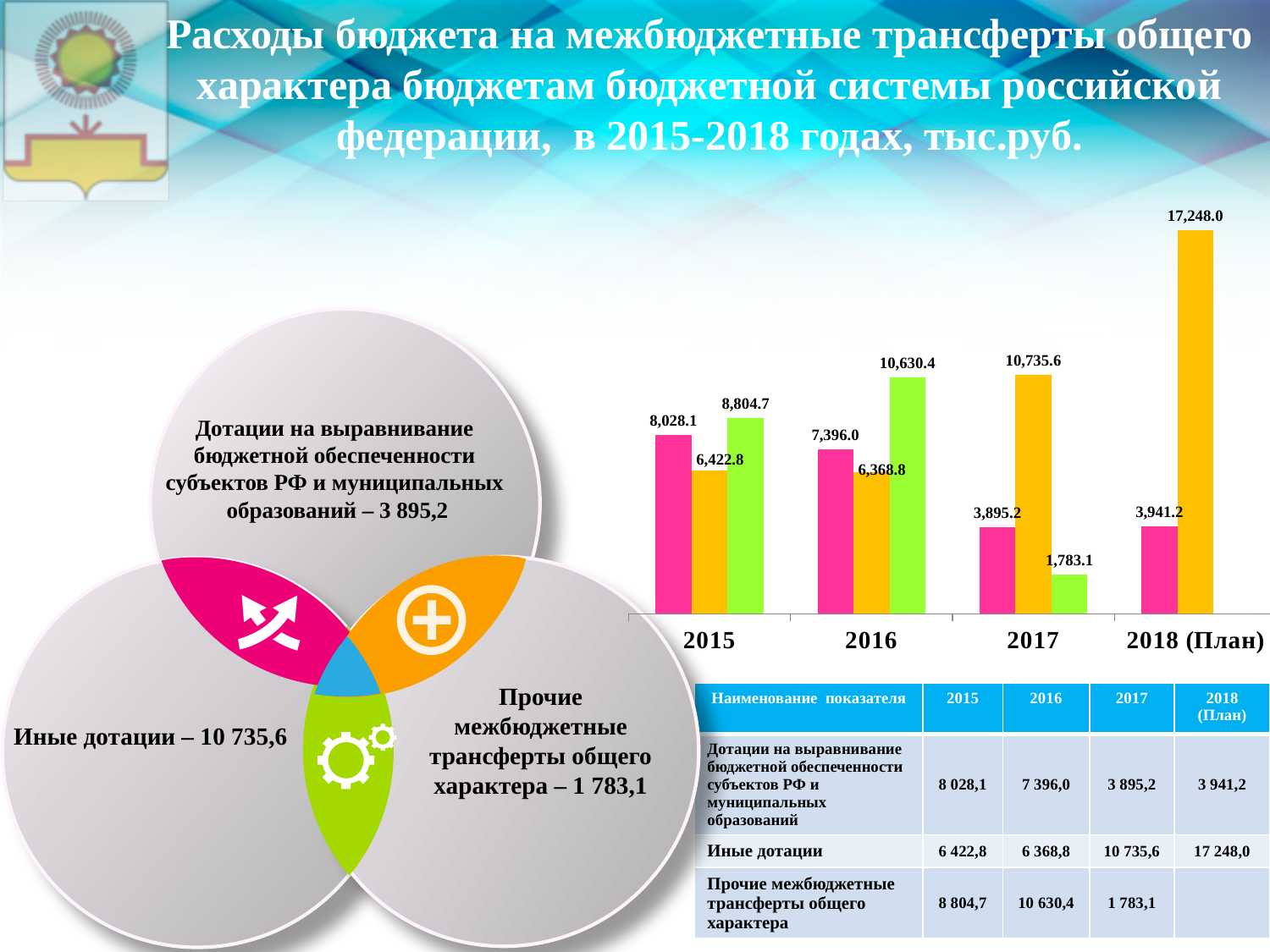
What type of chart is shown on the slide? Bar chart Do the orange bars rise or fall from 2016 to 2018 (План)? Rise How many year categories are shown on the x axis of the chart? 4 What is the value of the pink bar for 2015? 8,028.1 What is the value of the green bar for 2017? 1,783.1 What is the value of the orange bar for 2018 (План)? 17,248.0 What is the smallest labelled value in the chart? 1,783.1 Which year group contains the tallest bar in the chart? 2018 (План) What is the difference between the orange bar and the pink bar in 2017? 6,840.4 By how much does the orange bar for 2018 (План) exceed the orange bar for 2017? 6,512.4 In 2016, which is larger: the green bar or the pink bar? The green bar (10,630.4) What is the value of the green bar for 2016? 10,630.4